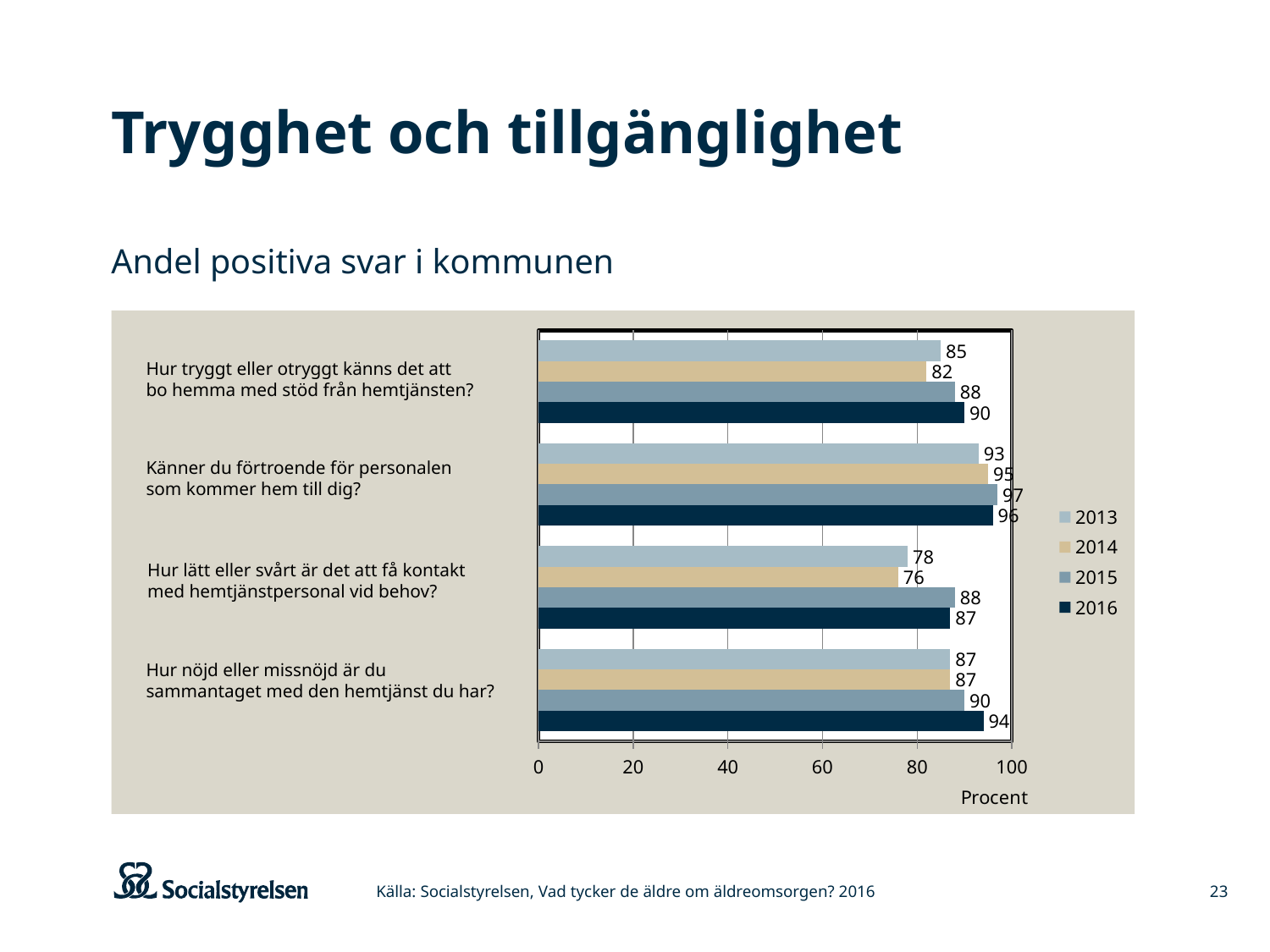
For "Hur lätt eller svårt är det att få kontakt med hemtjänstpersonal vid behov?", which year has the larger value, 2015 or 2016? 2015 What is the 2016 value for "Hur tryggt eller otryggt känns det att bo hemma med stöd från hemtjänsten?"? 90 Which question has the highest 2016 value? Känner du förtroende för personalen som kommer hem till dig? What is the 2013 value for "Hur nöjd eller missnöjd är du sammantaget med den hemtjänst du har?"? 87 How many questions (categories) are shown on the chart? 4 What is the 2014 value for "Hur lätt eller svårt är det att få kontakt med hemtjänstpersonal vid behov?"? 76 What is the 2015 value for "Känner du förtroende för personalen som kommer hem till dig?"? 97 How many series does the legend list? 4 What is the difference between the 2016 and 2013 values for "Hur nöjd eller missnöjd är du sammantaget med den hemtjänst du har?"? 7 What kind of chart is shown on the slide? Bar chart What is the label on the horizontal axis of the chart? Procent Which question has the lowest 2014 value? Hur lätt eller svårt är det att få kontakt med hemtjänstpersonal vid behov?